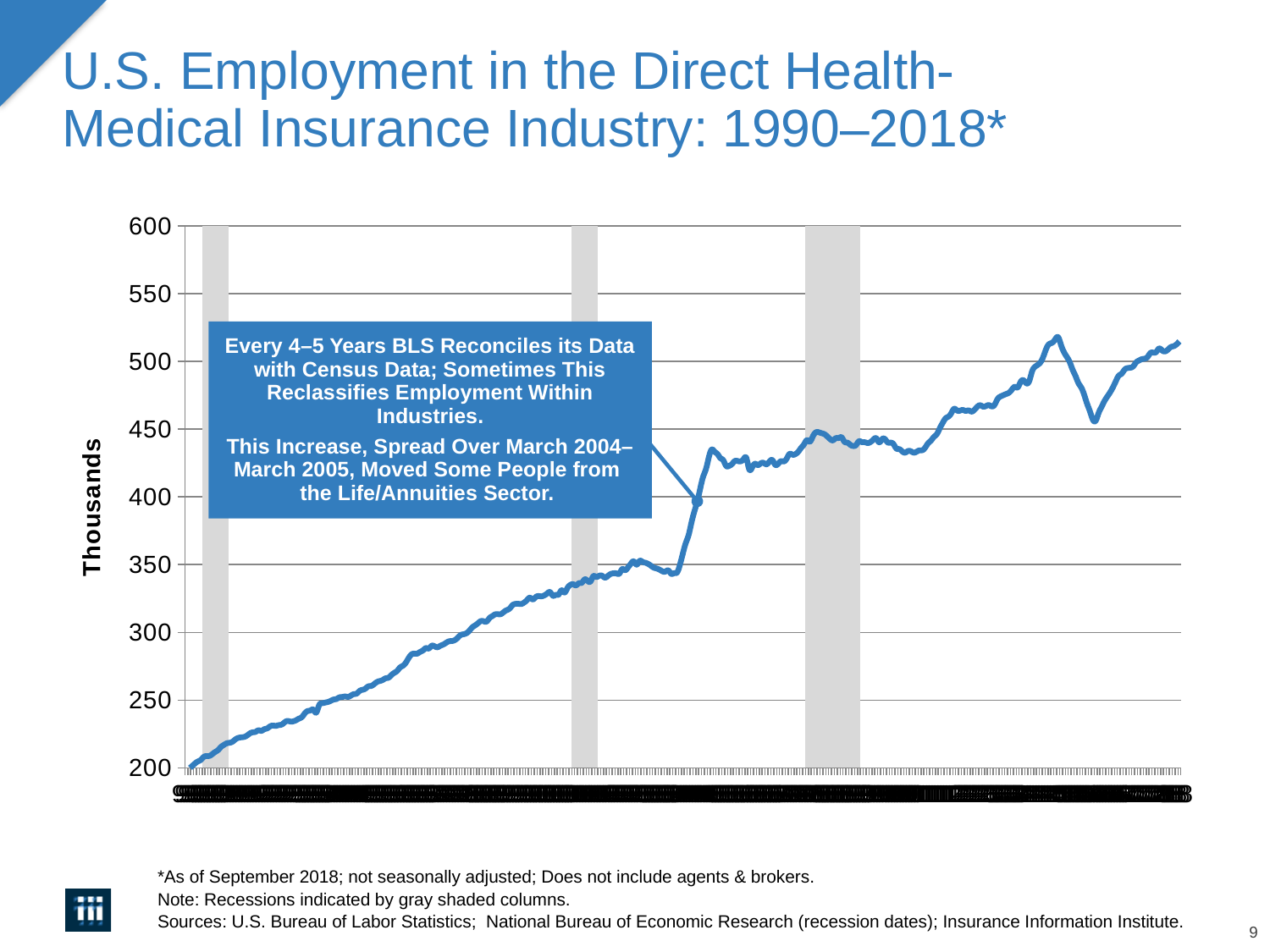
What is the label on the vertical axis? Thousands Do the values generally rise or fall from the start of the series in 1990 to the end in 2018? Rise Is the peak value reached in the series greater or less than 550? less What is the highest value shown on the vertical axis? 600 What is the title of the chart on the slide? U.S. Employment in the Direct Health-Medical Insurance Industry: 1990–2018* Is the value at the end of the series (September 2018) greater or less than 500? greater How many gray shaded recession columns appear on the chart? 3 What kind of chart is shown on the slide? Line chart Is the value at the start of the series (1990) greater or less than 250? less Is the value at the end of the series greater or less than the value at the start of the series? greater